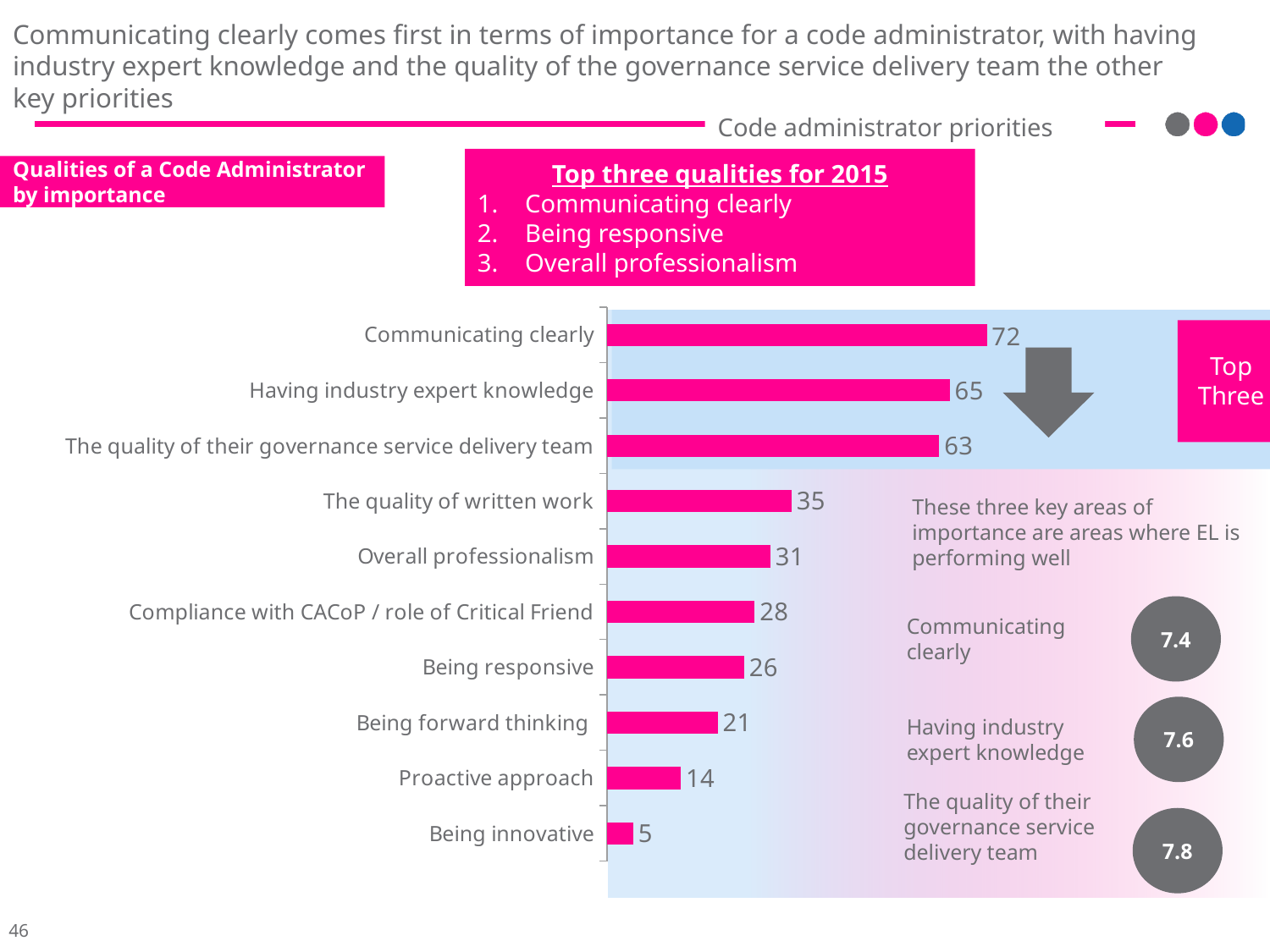
What kind of chart is shown on the slide? bar chart What is the value for Proactive approach? 14 How many categories are shown in the bar chart? 10 Which category has the lowest value? Being innovative What is the value for Communicating clearly? 72 What is the title of the chart shown in the pink box at the top left? Qualities of a Code Administrator by importance What is the difference between the values for Overall professionalism and Being forward thinking? 10 What is the value for The quality of written work? 35 Which is larger, the value for Compliance with CACoP / role of Critical Friend or the value for Being responsive? Compliance with CACoP / role of Critical Friend Which category has the highest value? Communicating clearly What is the difference between the values for Communicating clearly and Having industry expert knowledge? 7 What is the value for Being responsive? 26